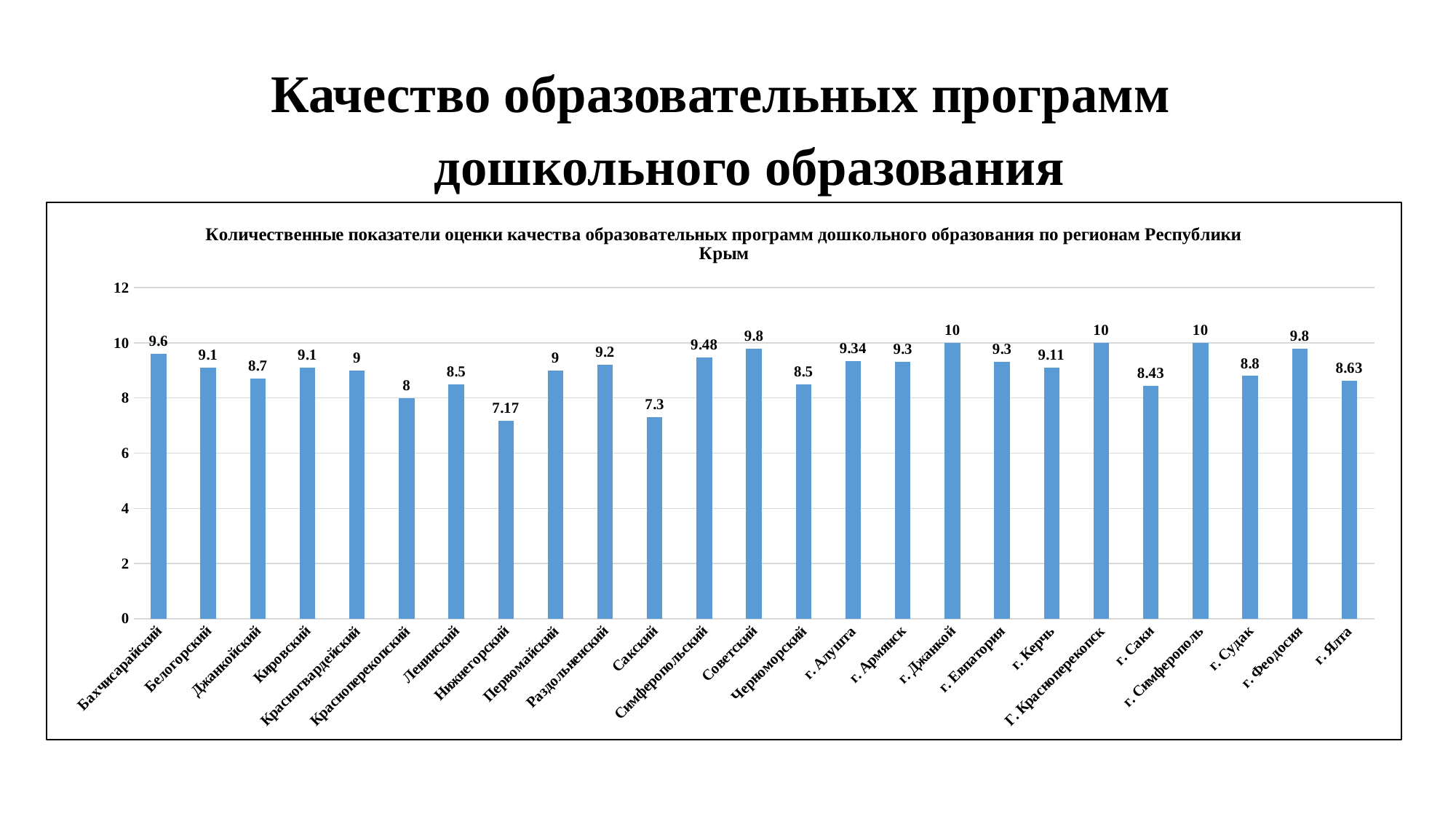
What is the value for г. Саки? 8.43 What is the value for Симферопольский? 9.48 What kind of chart is shown on the slide? bar chart How many regions have a value of 10? 3 What is the difference between the values for Бахчисарайский and Сакский? 2.3 Which has a larger value, Советский or Черноморский? Советский What is the difference between the values for г. Джанкой and г. Ялта? 1.37 How many regions are shown on the chart? 25 Is the value for Красноперекопский greater or less than 10? less What is the value for г. Феодосия? 9.8 Which region has the lowest value? Нижнегорский What is the value for Нижнегорский? 7.17